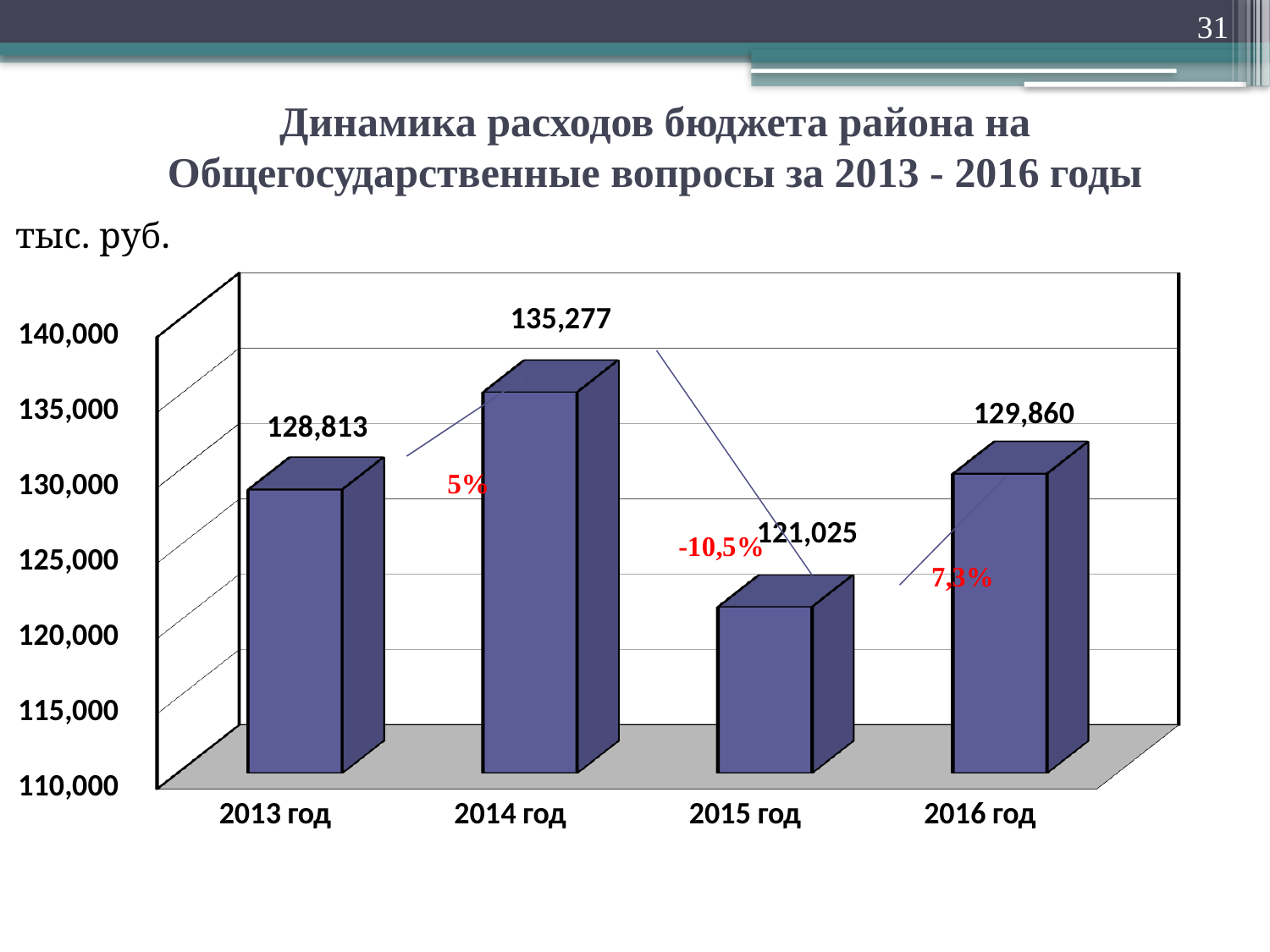
What is the difference between the values for 2014 год and 2013 год? 6,464 Which year has the highest value? 2014 год What percentage change is shown in red between 2014 год and 2015 год? -10,5% How many years are shown on the chart? 4 Is the value for 2015 год greater or less than 125,000? less Which is larger, the value for 2016 год or the value for 2013 год? 2016 год What is the difference between the values for 2014 год and 2015 год? 14,252 What is the value for 2013 год? 128,813 What is the value for 2015 год? 121,025 What kind of chart is shown on the slide? bar chart What is the value for 2016 год? 129,860 Which year has the lowest value? 2015 год